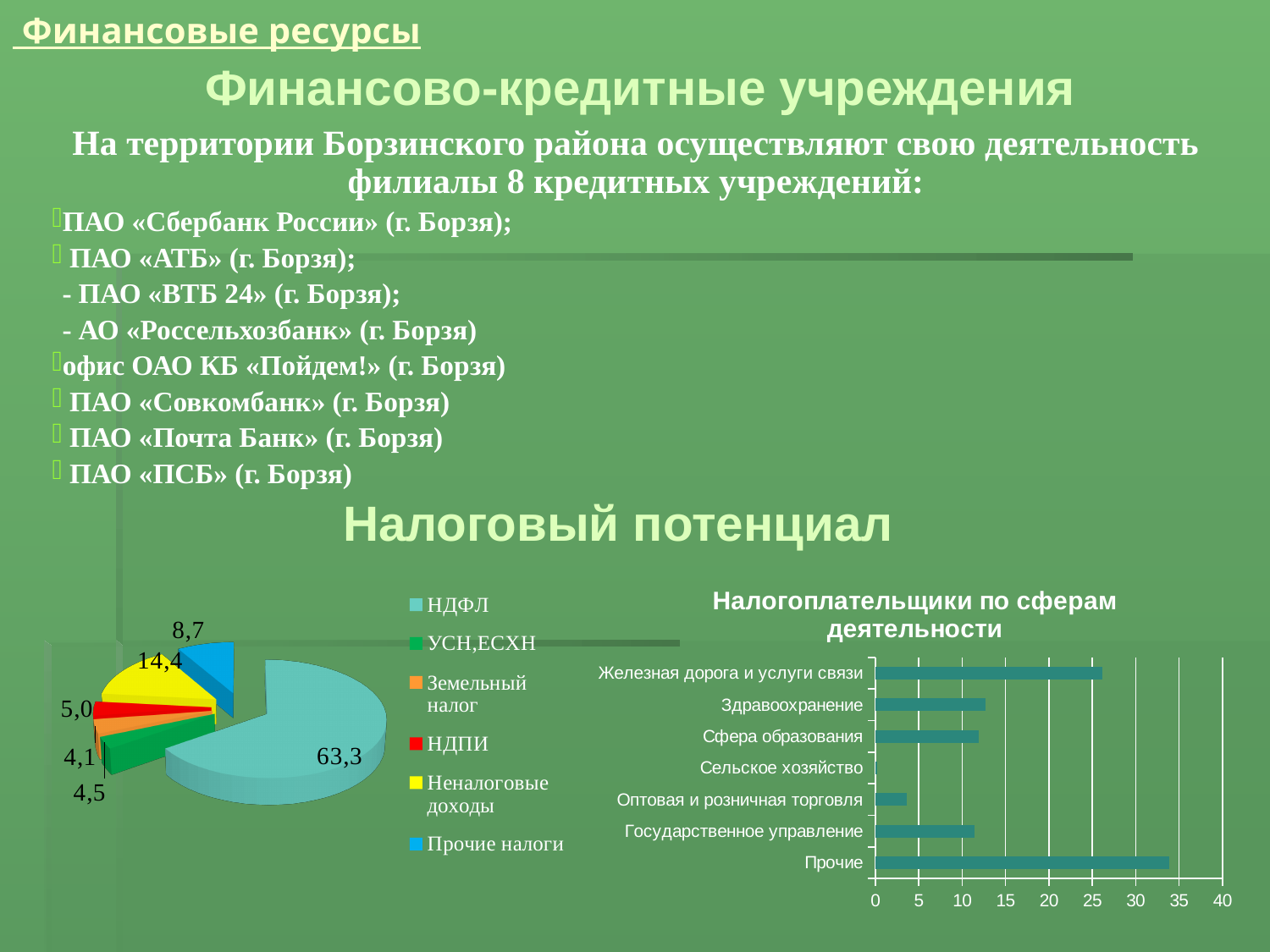
On the pie chart, what is the value shown for НДФЛ? 63,3 On the chart 'Налогоплательщики по сферам деятельности', is the value for Оптовая и розничная торговля greater or less than 5? less What kind of chart is the chart on the left of the slide? Pie chart On the chart 'Налогоплательщики по сферам деятельности', which category has the lowest value? Сельское хозяйство On the pie chart, what is the value shown for Неналоговые доходы? 14,4 On the chart 'Налогоплательщики по сферам деятельности', which is larger: Железная дорога и услуги связи or Здравоохранение? Железная дорога и услуги связи On the pie chart, what is the value shown for Прочие налоги? 8,7 On the chart 'Налогоплательщики по сферам деятельности', which category has the highest value? Прочие On the pie chart, how many entries does the legend list? 6 On the chart 'Налогоплательщики по сферам деятельности', how many categories are shown? 7 On the pie chart, which category has the largest slice? НДФЛ On the chart 'Налогоплательщики по сферам деятельности', is the value for Железная дорога и услуги связи greater or less than 25? greater